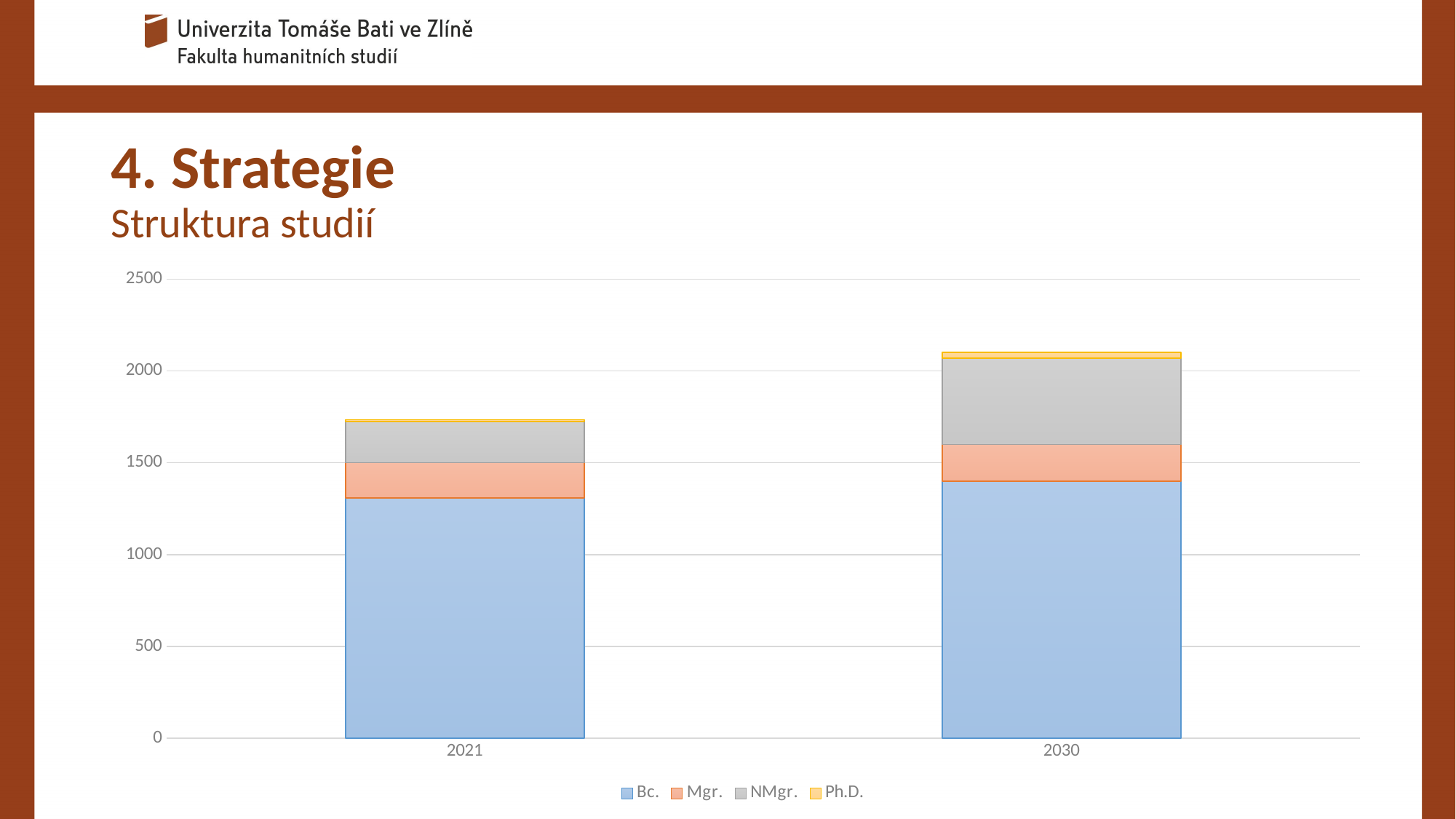
What kind of chart is shown on the slide? stacked bar chart How many series does the chart legend list? 4 Is the total of the stacked bar for 2030 greater or less than 2000? greater Is the Bc. value for 2030 greater or less than 1500? less Is the total of the stacked bar for 2021 greater or less than 2000? less Which series forms the largest segment of each stacked bar? Bc. Which series are listed in the chart legend? Bc., Mgr., NMgr., Ph.D. Which year has the taller stacked bar, 2021 or 2030? 2030 Do the stacked bar totals rise or fall from 2021 to 2030? rise How many categories are shown on the x axis of the chart? 2